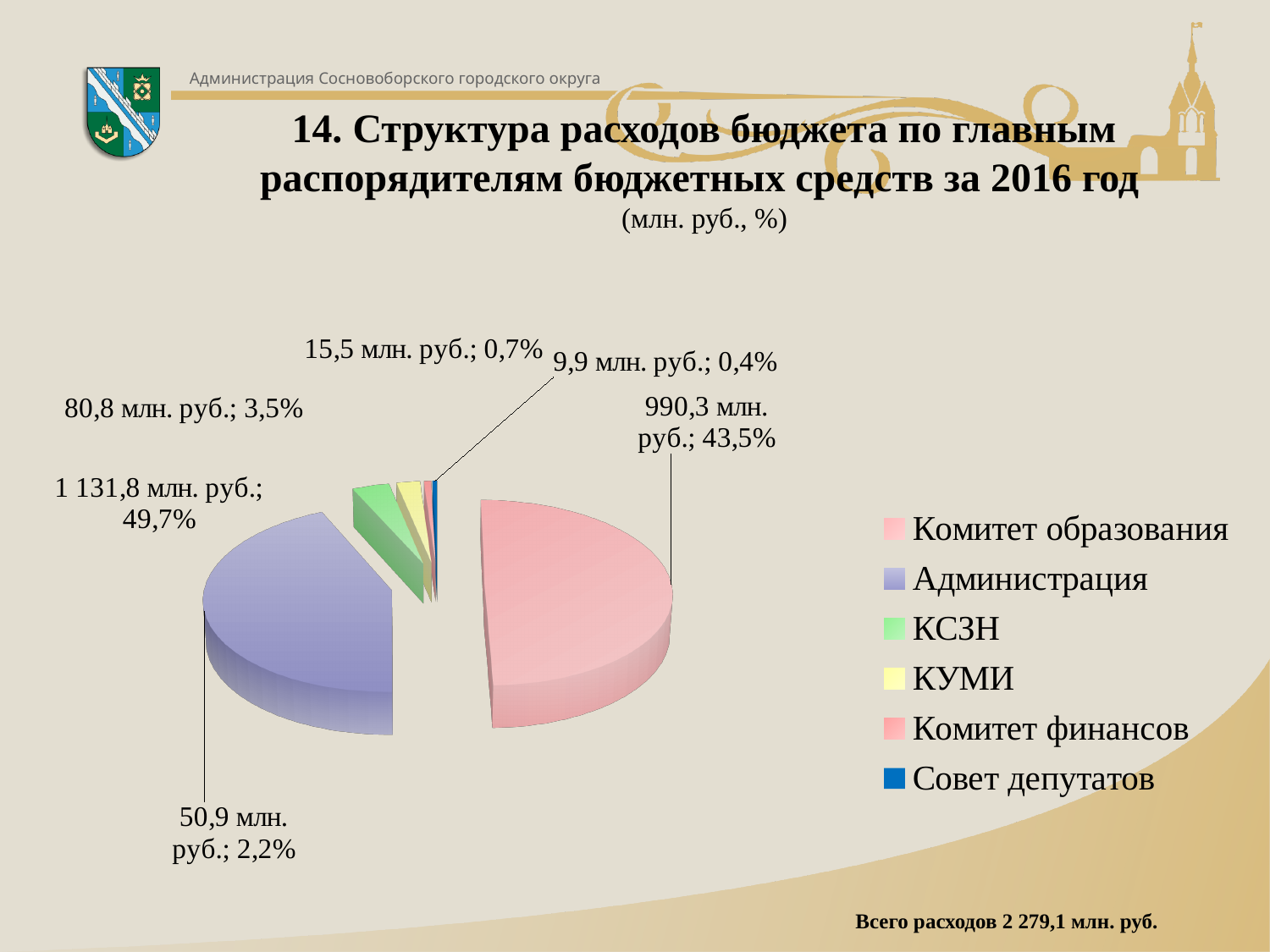
What share of the pie does Комитет образования have? 49,7% Which category has the smallest slice? Совет депутатов What kind of chart is shown on the slide? Pie chart What value is shown for Администрация? 990,3 млн. руб. What value is shown for КСЗН? 80,8 млн. руб. What is the difference between the values for Администрация and Комитет образования? 141,5 млн. руб. How many slices does the pie chart have? 6 What value is shown for Комитет образования? 1 131,8 млн. руб. Which category has the largest slice? Комитет образования What value is shown for КУМИ? 50,9 млн. руб. What is the total of expenditures stated on the slide? 2 279,1 млн. руб. What share of the pie does Администрация have? 43,5%